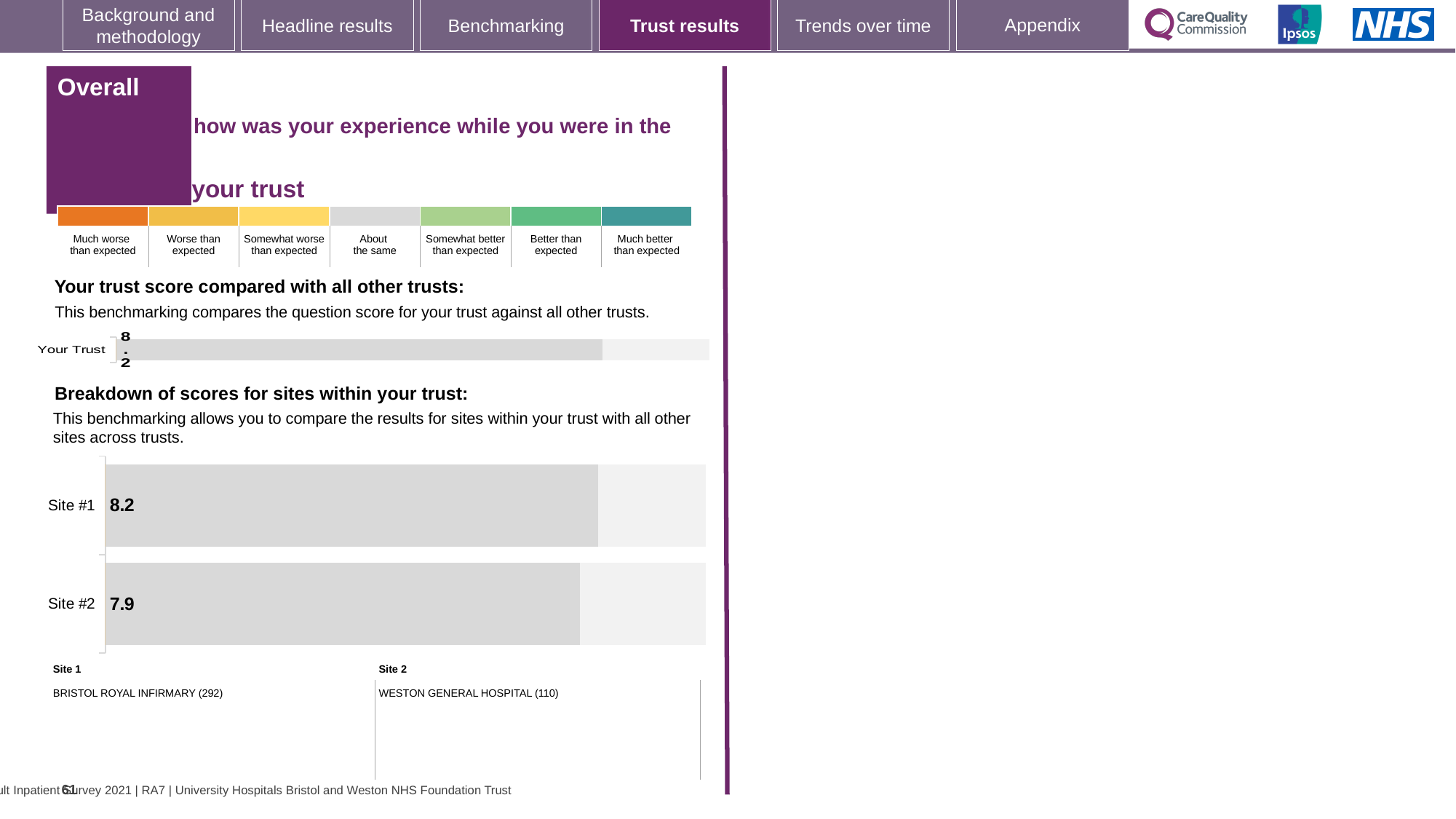
What type of chart is the 'Breakdown of scores for sites within your trust' chart? bar chart How many bars are shown in the 'Your trust score compared with all other trusts' chart? 1 According to the site key below the 'Breakdown of scores for sites within your trust' chart, which hospital is Site 1? BRISTOL ROYAL INFIRMARY (292) In the 'Your trust score compared with all other trusts' chart, what is the score shown for Your Trust? 8.2 In the 'Breakdown of scores for sites within your trust' chart, is the score for Site #1 larger or smaller than the score for Site #2? larger In the 'Breakdown of scores for sites within your trust' chart, what is the difference between the scores of Site #1 and Site #2? 0.3 How many sites are shown in the 'Breakdown of scores for sites within your trust' chart? 2 In the 'Breakdown of scores for sites within your trust' chart, what is the score for Site #2? 7.9 In the 'Breakdown of scores for sites within your trust' chart, what is the score for Site #1? 8.2 In the 'Breakdown of scores for sites within your trust' chart, which site has the lower score? Site #2 In the 'Breakdown of scores for sites within your trust' chart, which site has the higher score? Site #1 According to the site key below the 'Breakdown of scores for sites within your trust' chart, which hospital is Site 2? WESTON GENERAL HOSPITAL (110)